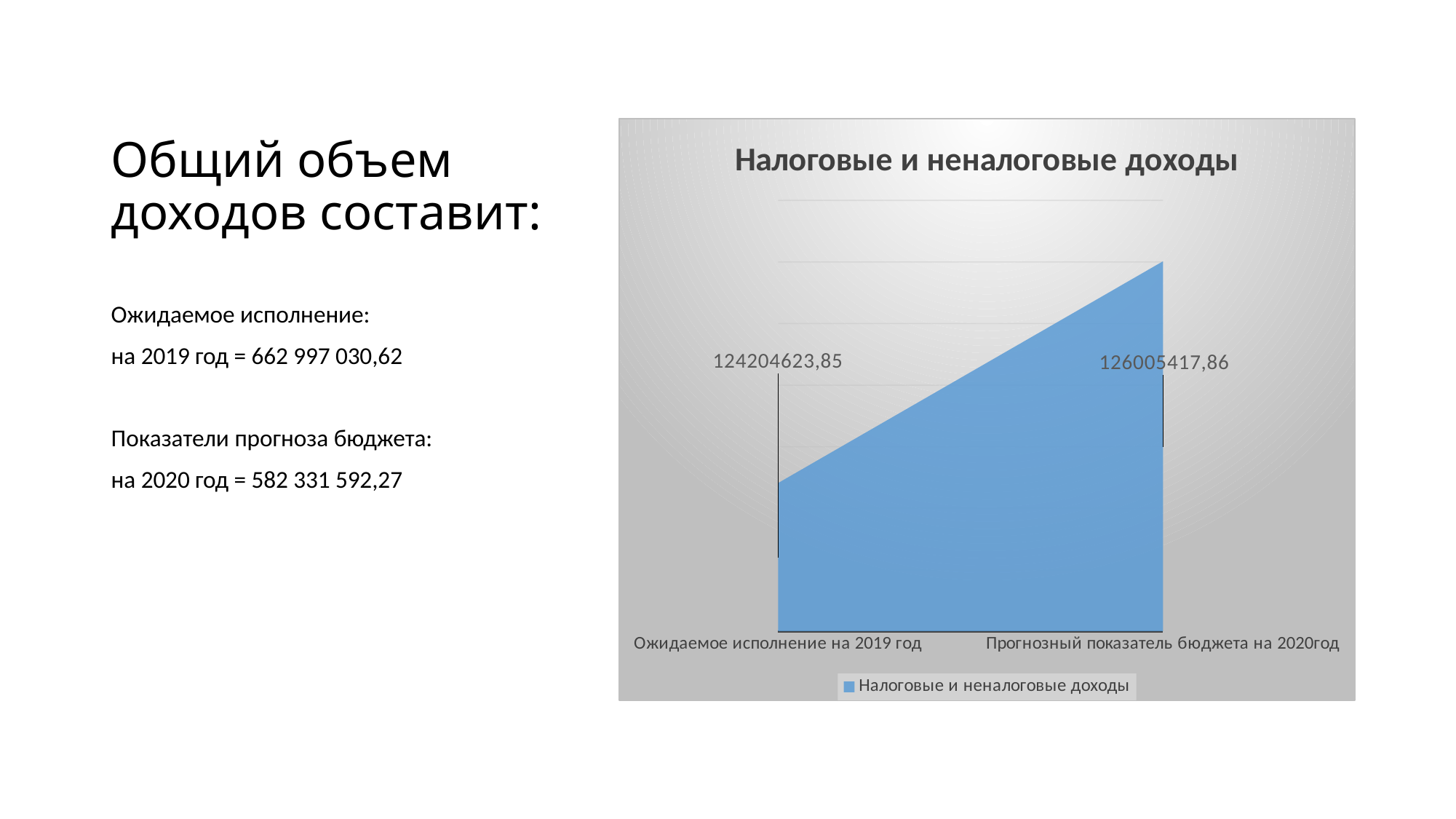
Which category has the higher value in the chart? Прогнозный показатель бюджета на 2020год What is the difference between the 2020 forecast value and the 2019 expected value in the chart? 1800794,01 Is the value for "Ожидаемое исполнение на 2019 год" larger or smaller than the value for "Прогнозный показатель бюджета на 2020год"? smaller How many series does the chart legend list? 1 Which category has the lower value in the chart? Ожидаемое исполнение на 2019 год What type of chart is shown on the slide? area chart Do the values rise or fall from the 2019 category to the 2020 category? rise What is the value for "Ожидаемое исполнение на 2019 год" in the chart? 124204623,85 What is the value for "Прогнозный показатель бюджета на 2020год" in the chart? 126005417,86 What is the title of the chart? Налоговые и неналоговые доходы How many categories are plotted on the x axis of the chart? 2 What series name is shown in the chart legend? Налоговые и неналоговые доходы